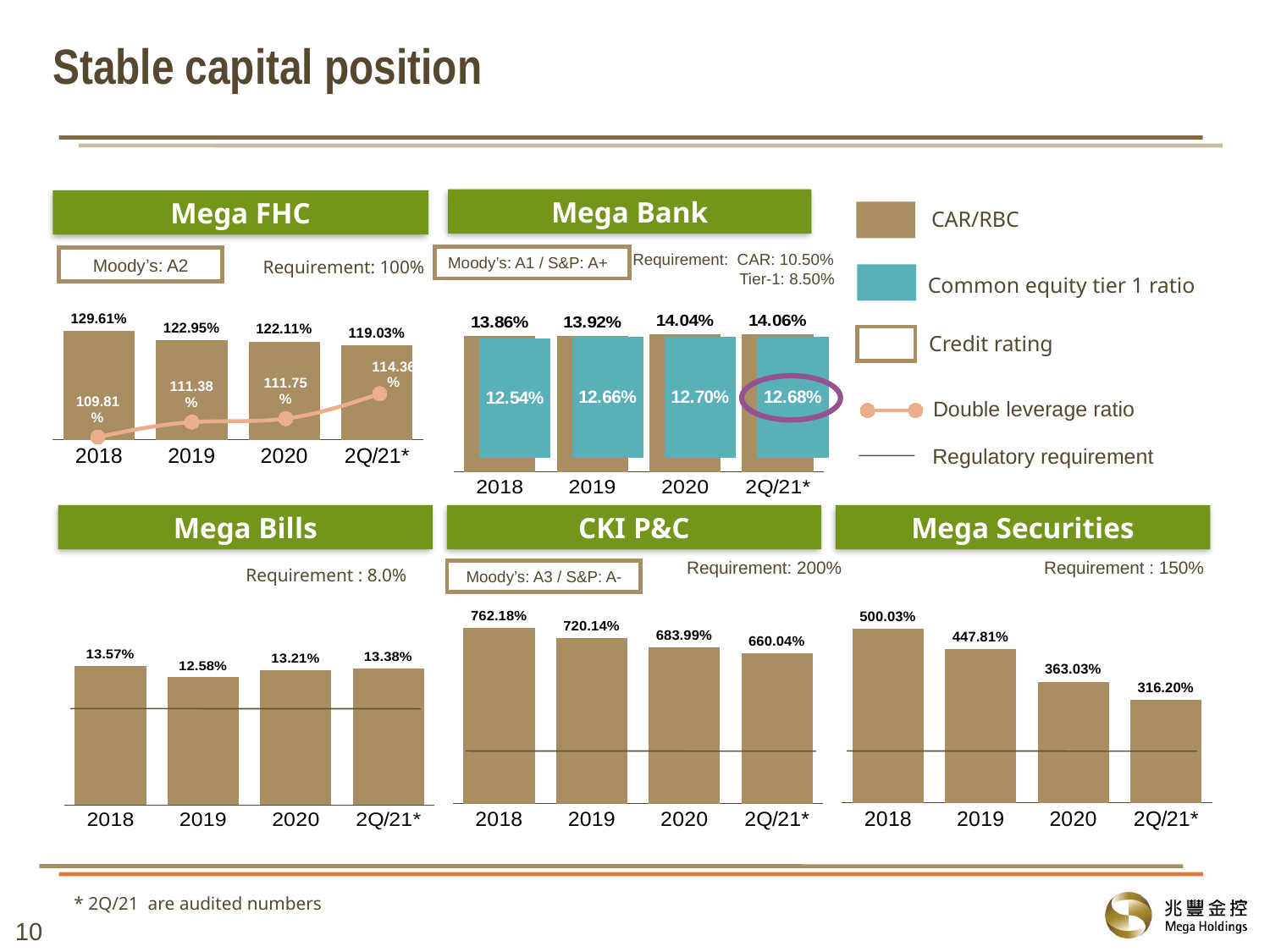
In the Mega Bills chart, which year has the lowest value? 2019 In the Mega Bank chart, what is the difference between the CAR/RBC and common equity tier 1 ratio for 2019? 1.26% According to the legend, what does the line with circular markers represent? Double leverage ratio In the Mega Bank chart, which year has the highest CAR/RBC value? 2Q/21* How many years are shown on the x axis of the CKI P&C chart? 4 In the Mega Securities chart, is the value for 2019 larger or smaller than the value for 2020? larger In the Mega Bank chart, what is the common equity tier 1 ratio for 2020? 12.70% In the Mega FHC chart, what is the double leverage ratio for 2Q/21*? 114.36% In the Mega Securities chart, do the values rise or fall from 2018 to 2Q/21*? fall In the Mega FHC chart, what is the CAR/RBC value for 2018? 129.61% In the CKI P&C chart, what is the difference between the 2018 and 2Q/21* values? 102.14% What kind of chart is the Mega Bills chart? bar chart